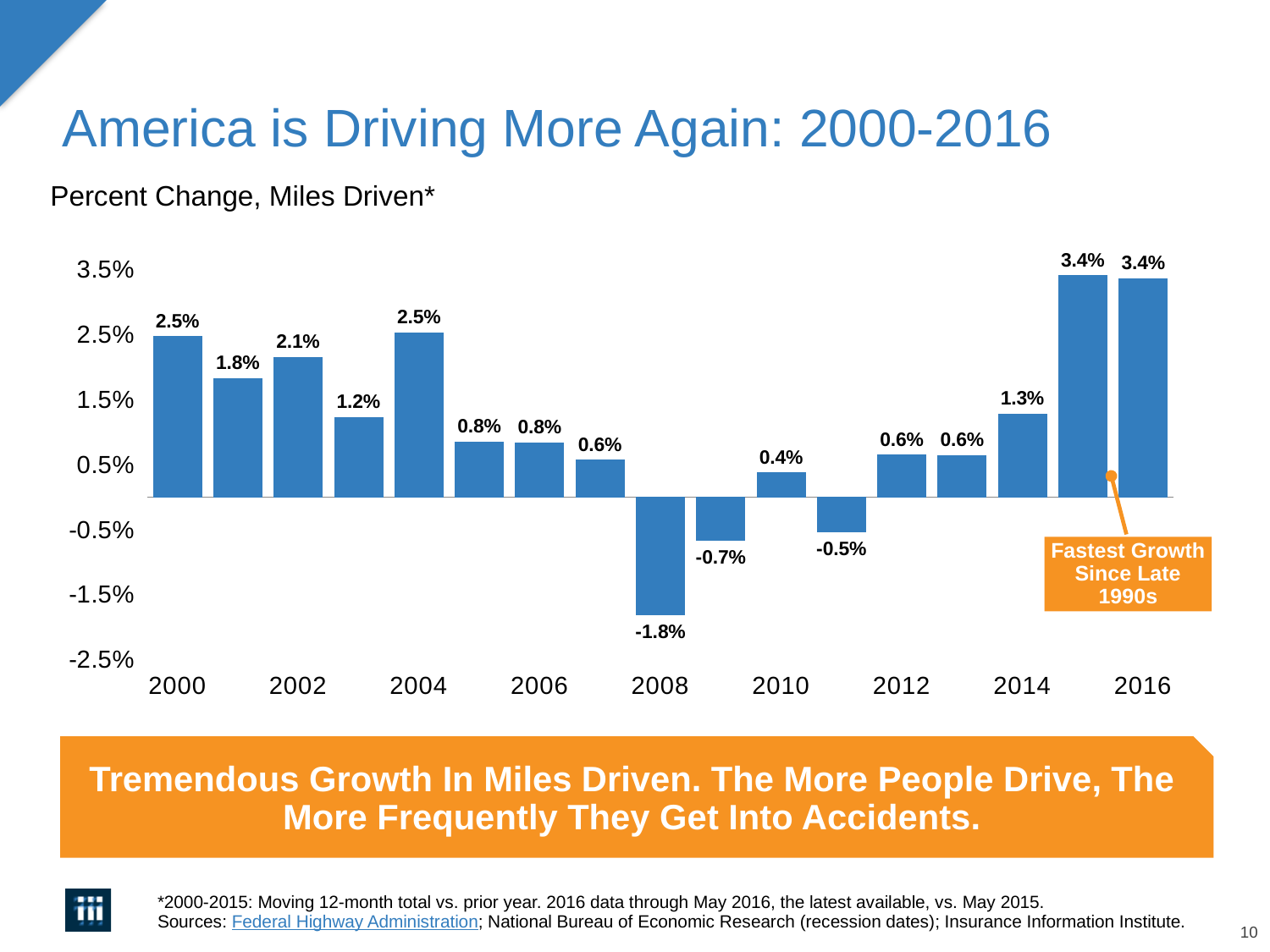
Which year has a larger percent change, 2004 or 2006? 2004 What is the difference between the percent change for 2016 and for 2014? 2.1% What is the percent change in miles driven for 2000? 2.5% What is the percent change in miles driven for 2016? 3.4% What is the percent change in miles driven for 2008? -1.8% What is the percent change in miles driven for 2010? 0.4% What does the orange callout on the chart say? Fastest Growth Since Late 1990s What type of chart is shown on the slide? bar chart What is the highest percent change value shown on the chart? 3.4% What is the subtitle describing the measure plotted on the chart? Percent Change, Miles Driven* Which year has the lowest percent change in miles driven? 2008 How many bars are plotted on the chart? 17